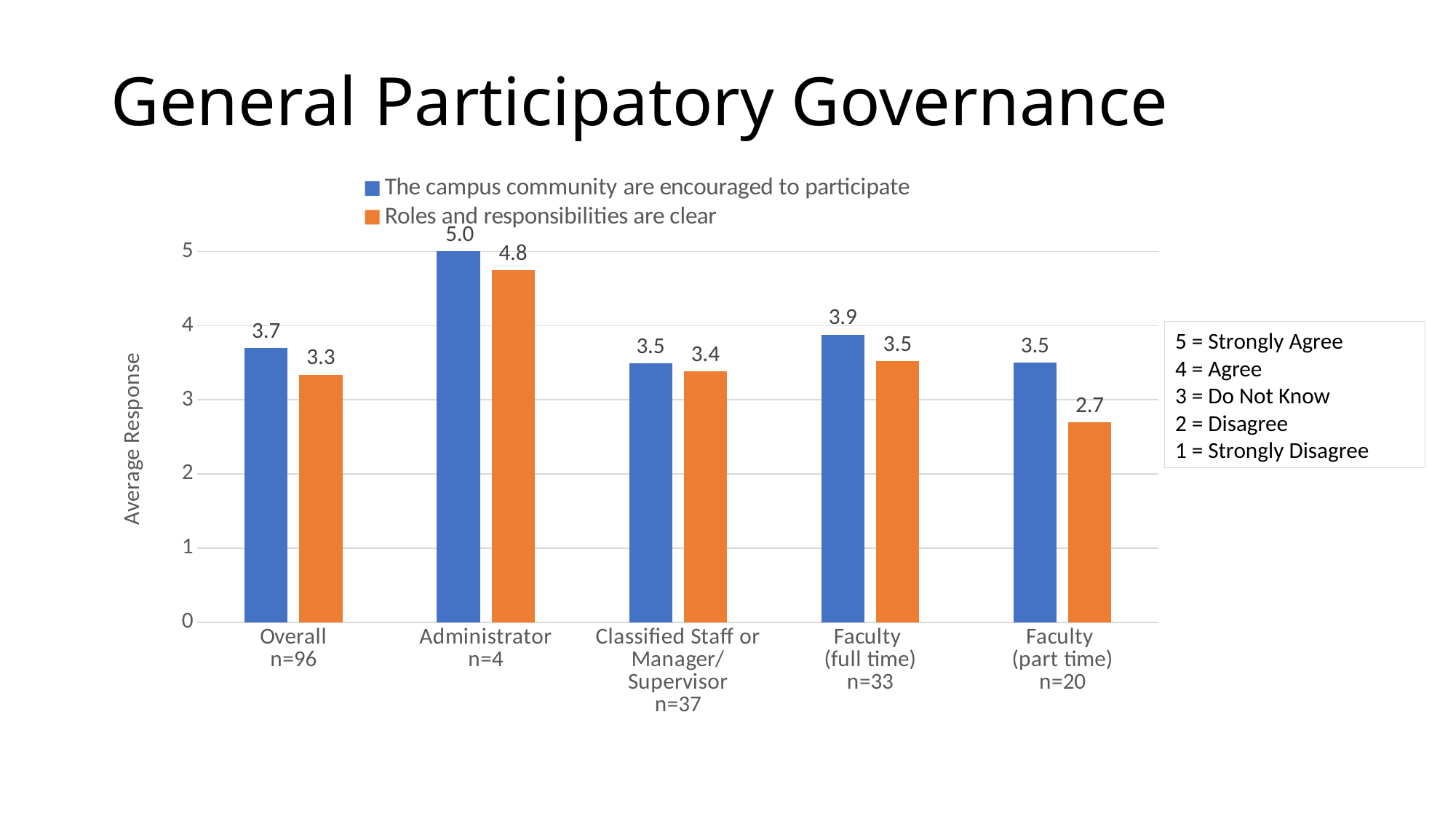
What is the value for Administrator for 'The campus community are encouraged to participate'? 5.0 How many categories are shown on the x axis? 5 What is the difference between the two series for Faculty (part time)? 0.8 What is the Overall value for 'Roles and responsibilities are clear'? 3.3 Which category has the highest value for 'The campus community are encouraged to participate'? Administrator How many series does the legend list? 2 What is the difference between the Administrator and Overall values for 'The campus community are encouraged to participate'? 1.3 Is the value for Faculty (part time) for 'Roles and responsibilities are clear' greater or less than 3? less Which category has the lowest value for 'Roles and responsibilities are clear'? Faculty (part time) What kind of chart is shown on the slide? Bar chart What is the value for Faculty (part time) for 'Roles and responsibilities are clear'? 2.7 For Faculty (full time), which series has the larger value? The campus community are encouraged to participate